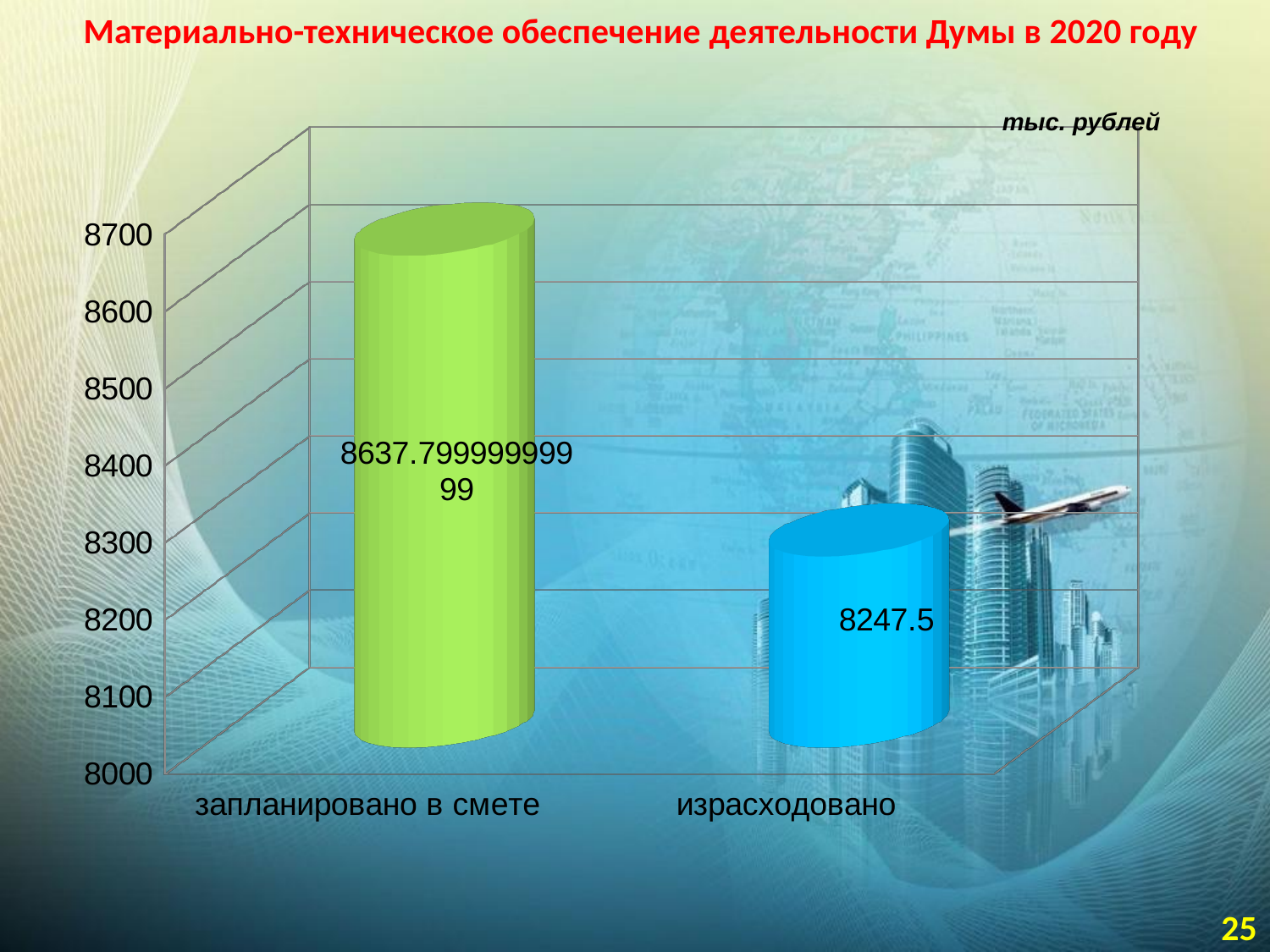
What is the title of the slide? Материально-техническое обеспечение деятельности Думы в 2020 году Which is larger, запланировано в смете or израсходовано? запланировано в смете What kind of chart is shown on the slide? bar chart How many categories are shown on the x axis? 2 What is the value for израсходовано? 8247.5 In what units are the chart values given, according to the label above the chart? тыс. рублей Which category has the lowest value? израсходовано Is the value for израсходовано greater or less than 8300? less What value is printed on the bar for запланировано в смете? 8637.79999999999 Is the value for запланировано в смете greater or less than 8600? greater Which category has the highest value? запланировано в смете Do the values rise or fall from left to right along the x axis? fall